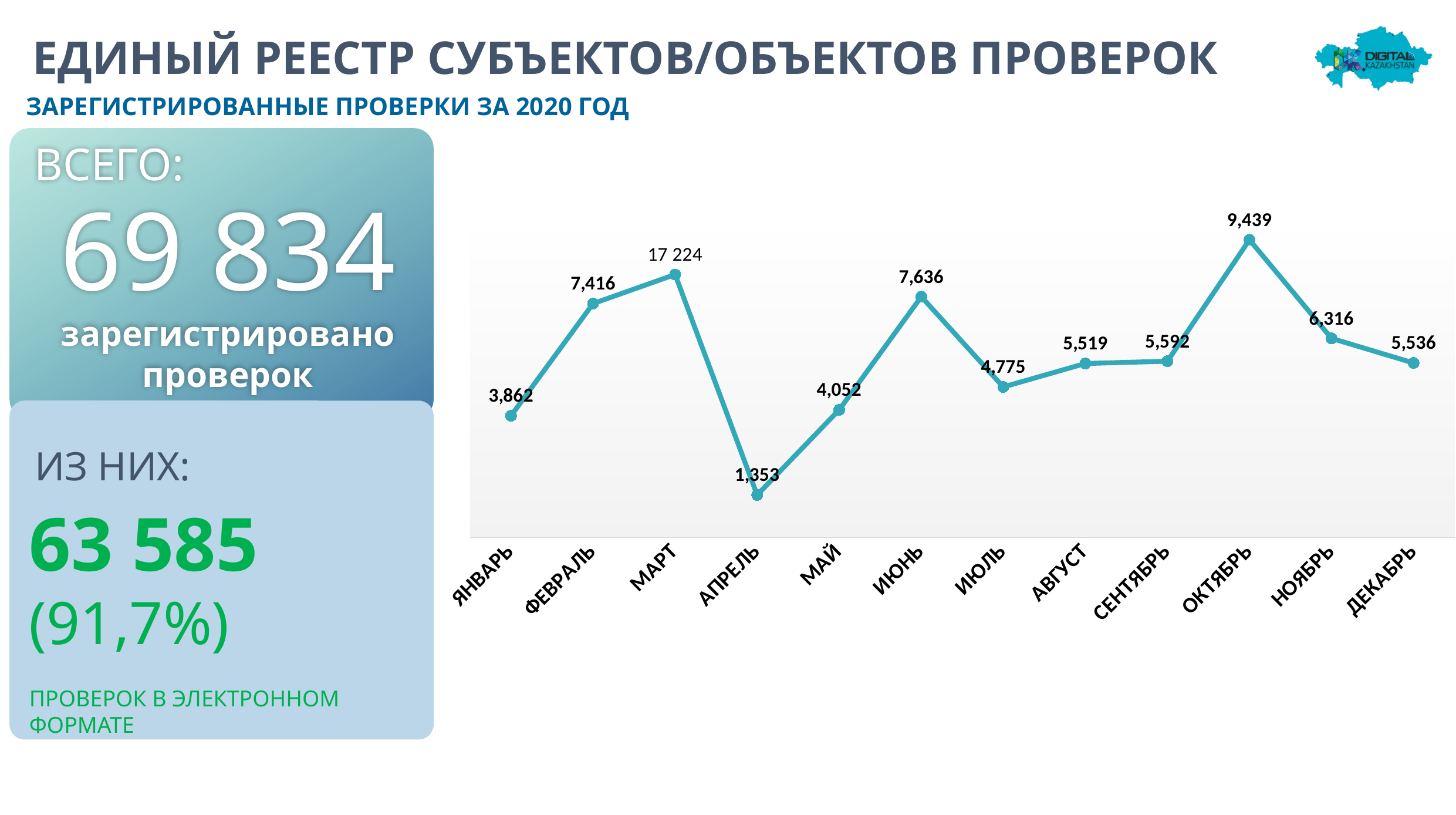
Do the values rise or fall from ОКТЯБРЬ to ДЕКАБРЬ? fall What is the value for АПРЕЛЬ on the line chart? 1,353 How many months are plotted on the line chart? 12 Which month has the lowest value on the line chart? АПРЕЛЬ What is the difference between the values for ОКТЯБРЬ and НОЯБРЬ? 3,123 What is the value for ОКТЯБРЬ on the line chart? 9,439 What kind of chart is shown on the slide? line chart What is the value for ЯНВАРЬ on the line chart? 3,862 What is the difference between the values for ИЮНЬ and МАЙ? 3,584 What is the value for МАРТ on the line chart? 17 224 Which is larger, the value for ФЕВРАЛЬ or the value for ИЮНЬ? ИЮНЬ